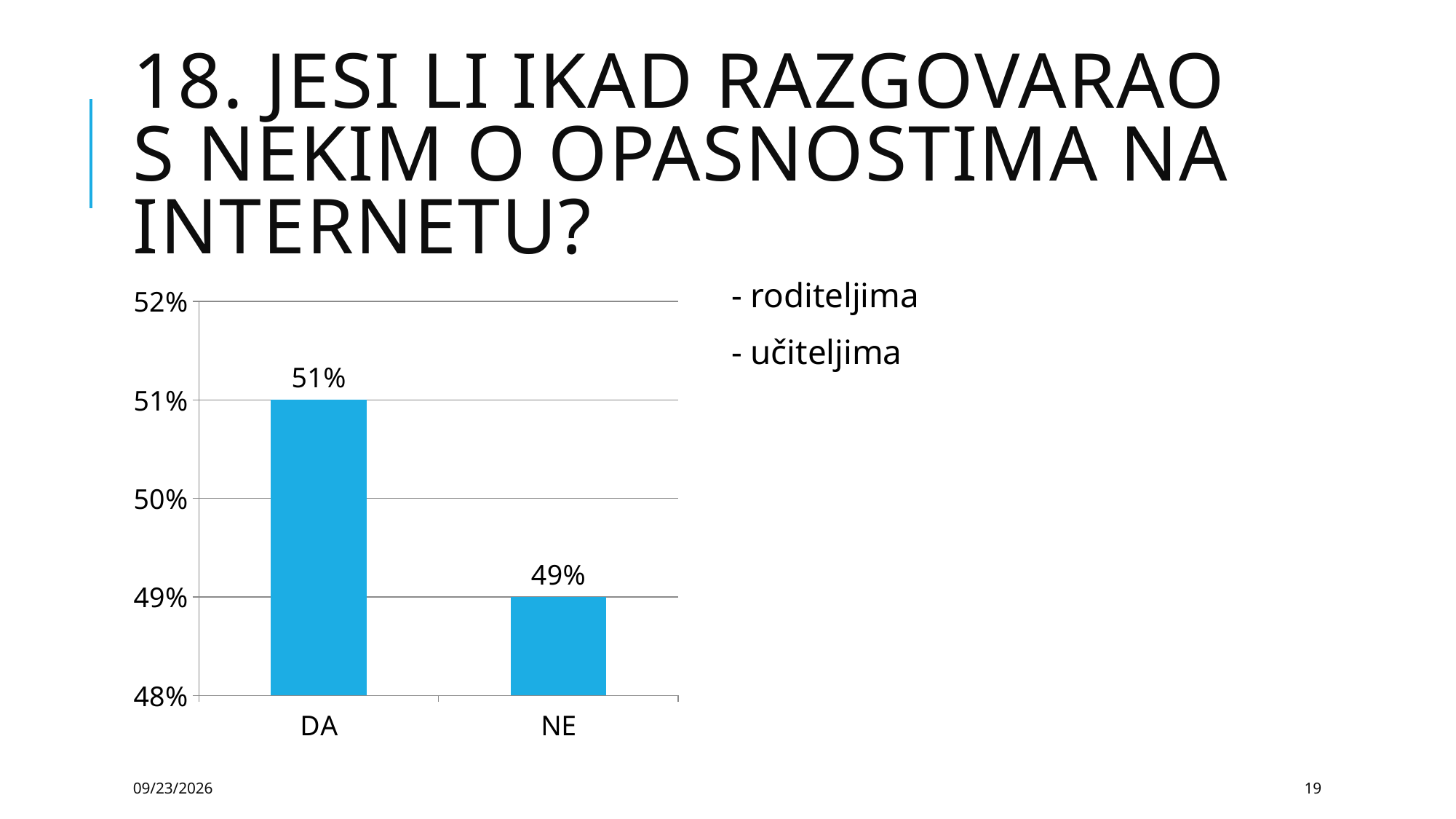
How many categories are shown on the x axis? 2 Which is larger, the value for DA or the value for NE? DA Which category has the highest value? DA What is the value for NE? 49% What is the value for DA? 51% Which category has the lowest value? NE Do the values rise or fall from DA to NE? fall What is the difference between the values for DA and NE? 2% Is the value for NE greater or less than 50%? less What is the lowest value shown on the y axis? 48% What kind of chart is shown on the slide? bar chart Is the value for DA greater or less than 50%? greater